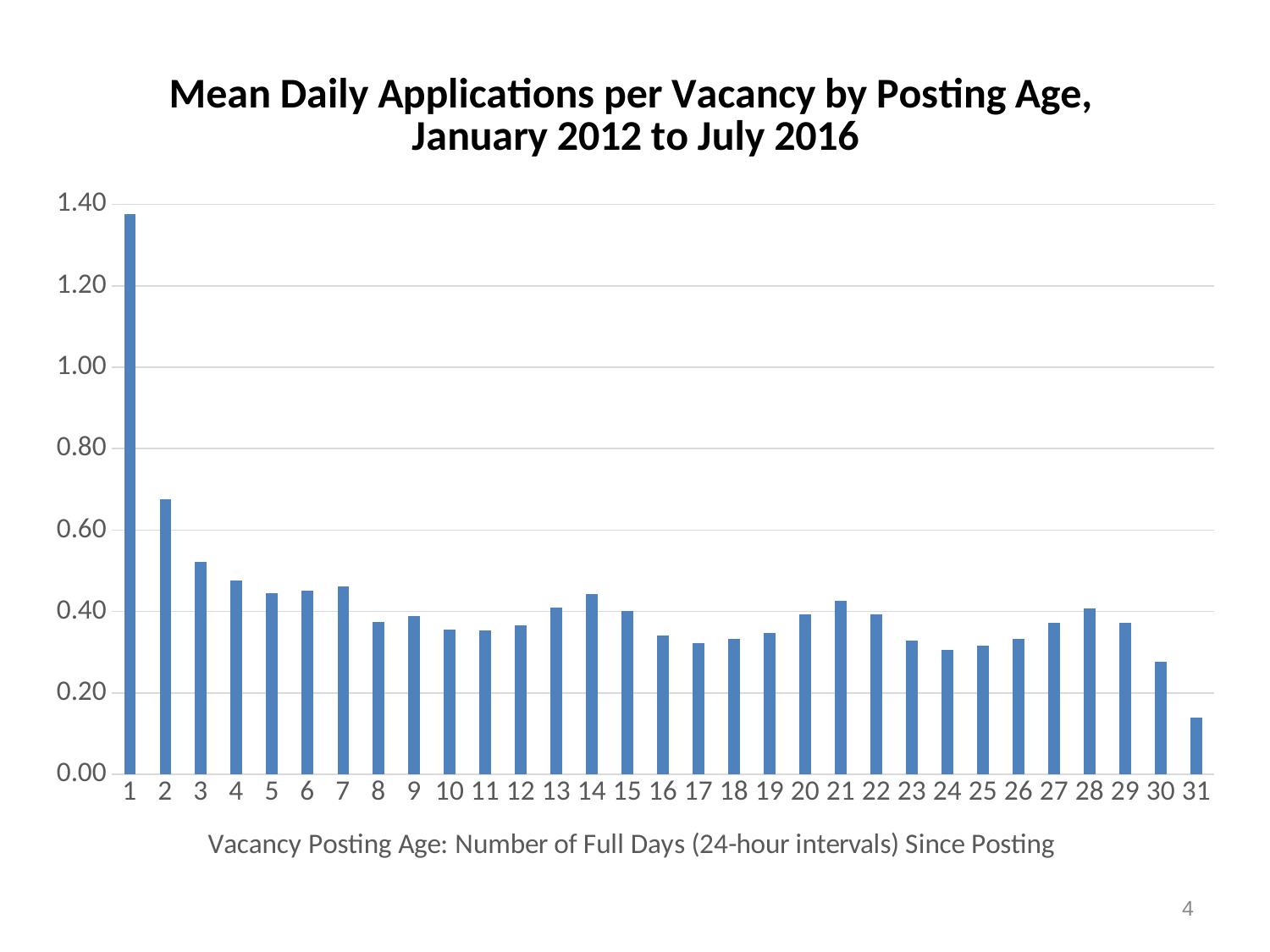
Is the value for posting age 1 greater or less than 1.20? greater Which posting age has the lowest mean daily applications per vacancy? 31 Is the value for posting age 24 greater or less than 0.40? less Overall, do the values rise or fall as posting age increases from 1 to 31? Fall What is the title of the chart? Mean Daily Applications per Vacancy by Posting Age, January 2012 to July 2016 Is the value for posting age 31 greater or less than 0.20? less Which has a larger value, posting age 1 or posting age 2? Posting age 1 What kind of chart is shown on the slide? Bar chart How many posting-age categories are plotted on the x axis? 31 Which posting age has the highest mean daily applications per vacancy? 1